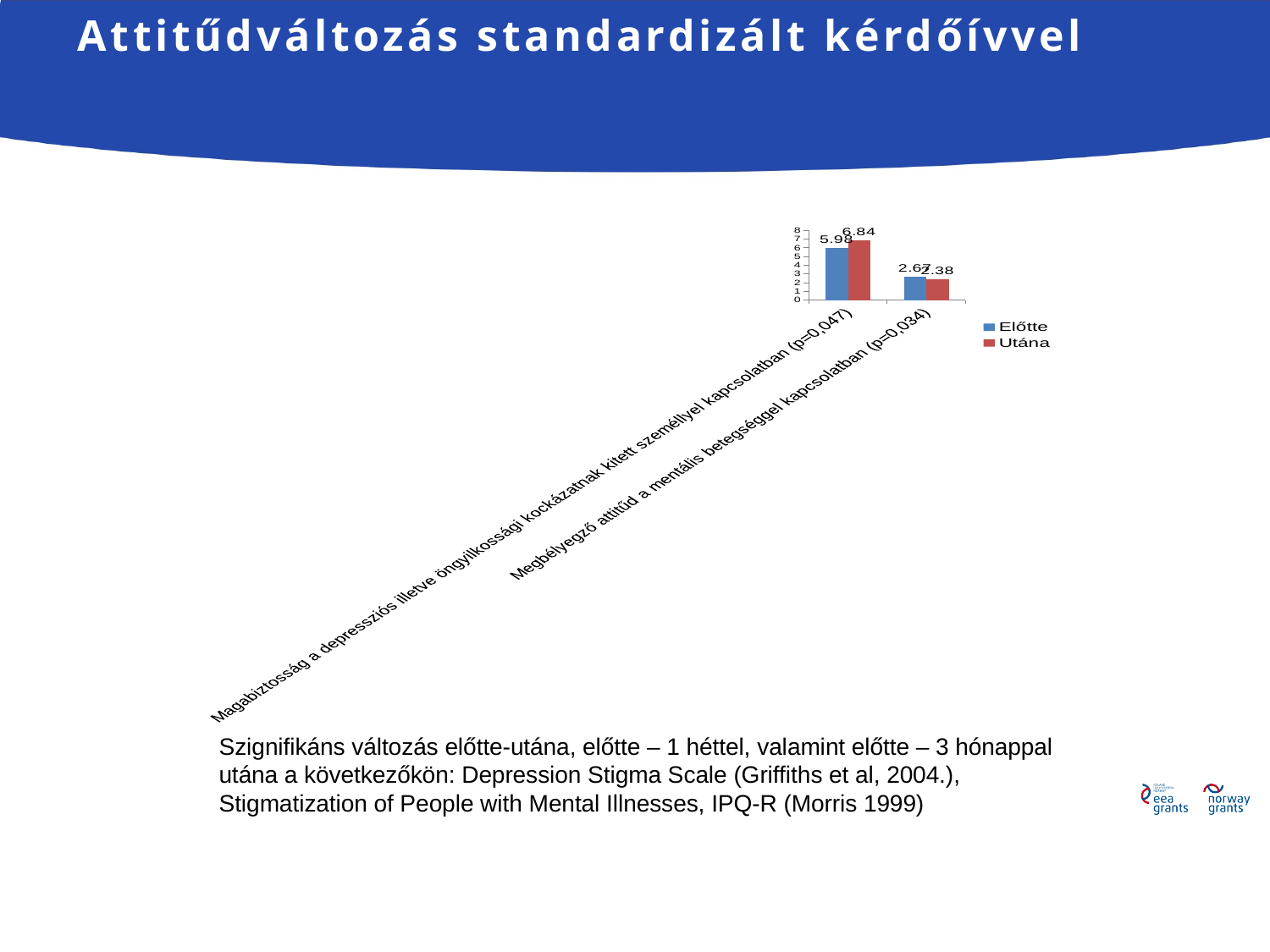
What is the Utána value for the category 'Megbélyegző attitűd a mentális betegséggel kapcsolatban (p=0,034)'? 2.38 What is the Utána value for the category 'Magabiztosság a depressziós illetve öngyilkossági kockázatnak kitett személlyel kapcsolatban (p=0,047)'? 6.84 What is the Előtte value for the category 'Magabiztosság a depressziós illetve öngyilkossági kockázatnak kitett személlyel kapcsolatban (p=0,047)'? 5.98 What are the two series named in the legend? Előtte and Utána What is the Előtte value for the category 'Megbélyegző attitűd a mentális betegséggel kapcsolatban (p=0,034)'? 2.67 Which category has the highest Utána value? Magabiztosság a depressziós illetve öngyilkossági kockázatnak kitett személlyel kapcsolatban (p=0,047) How many categories are shown on the x axis? 2 How many series does the legend list? 2 What is the difference between the Utána and Előtte values for the 'Magabiztosság...' category? 0.86 Is the Előtte value for the 'Magabiztosság...' category greater or less than 5? greater What kind of chart is shown on the slide? bar chart For the 'Magabiztosság...' category, which is larger, the Előtte or the Utána value? Utána